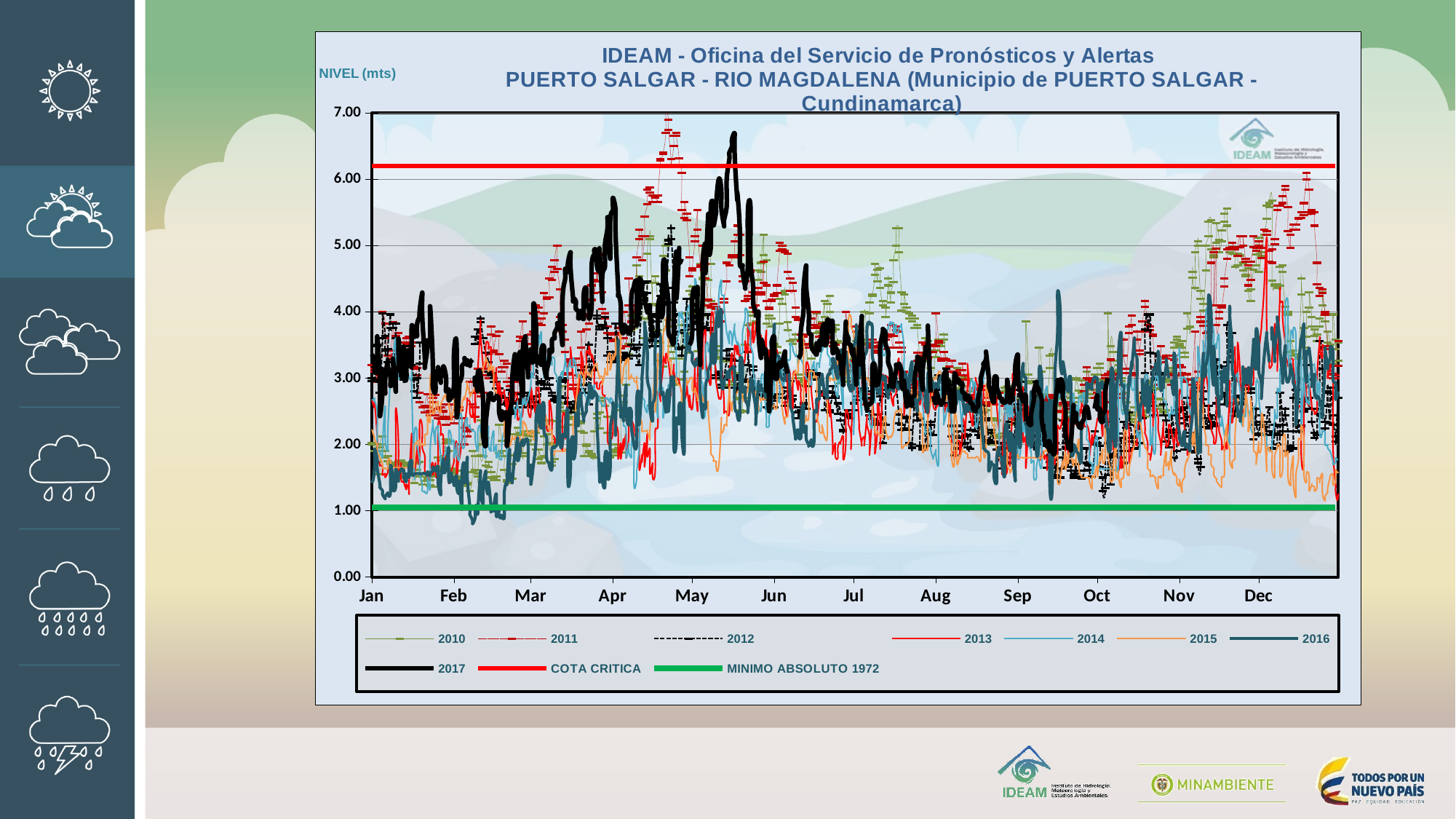
Is the peak value of the 2017 series in May greater or less than 6.00? greater How many months are labelled along the x axis? 12 Is the COTA CRITICA line greater or less than 6.00? greater What is the label of the y axis? NIVEL (mts) What kind of chart is shown on the slide? line chart Which horizontal reference line is higher, COTA CRITICA or MINIMO ABSOLUTO 1972? COTA CRITICA Is the peak value of the 2011 series around late April greater or less than 6.00? greater How many series does the legend list? 10 What is the highest value shown on the y axis? 7.00